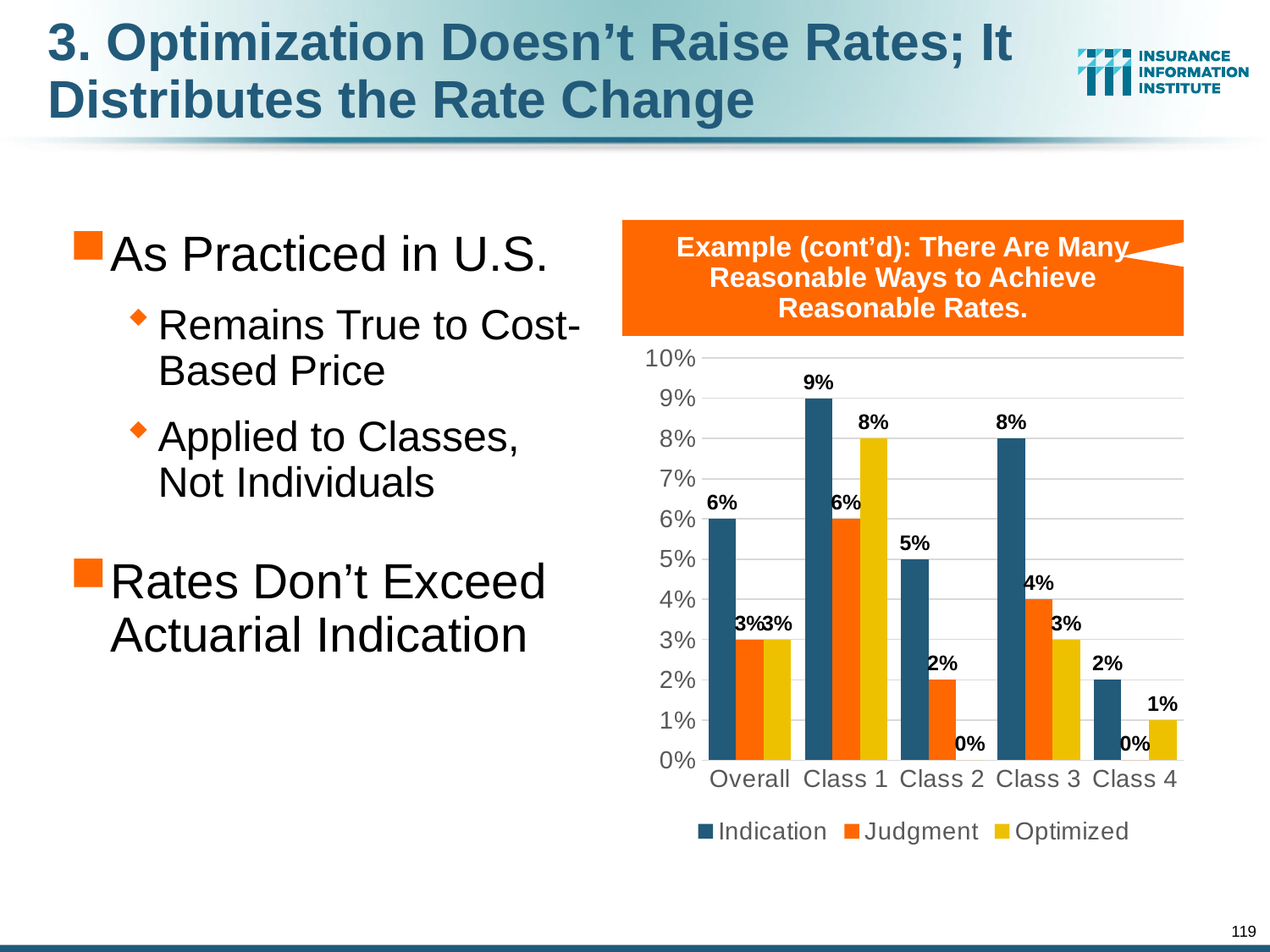
What is the Optimized value for Class 2? 0% How many series does the legend list? 3 What is the Indication value for Class 1? 9% What is the difference between the Indication and Judgment values for Class 2? 3% What is the Judgment value for Class 3? 4% Which category has the highest Indication value? Class 1 Which category has the lowest Indication value? Class 4 What is the title of the chart? Example (cont'd): There Are Many Reasonable Ways to Achieve Reasonable Rates. How many categories are shown on the x axis? 5 What is the Optimized value for Class 4? 1% Which is larger for Class 1, the Judgment value or the Optimized value? Optimized What kind of chart is shown on the slide? Bar chart